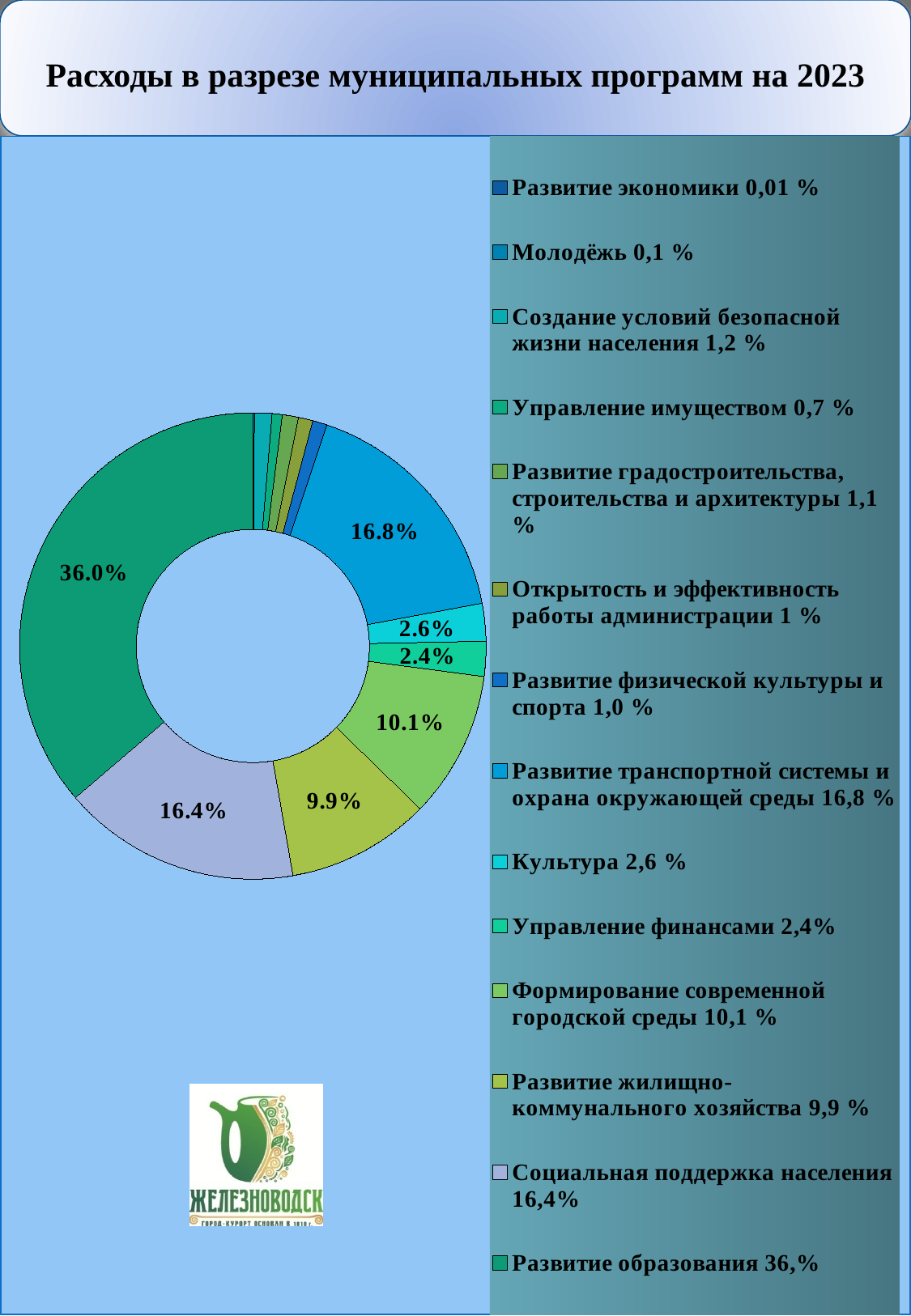
What is the title of the slide? Расходы в разрезе муниципальных программ на 2023 What kind of chart is shown on the slide? pie chart (doughnut) What is the difference between the shares of Развитие образования and Социальная поддержка населения? 19.6% What share is shown for Формирование современной городской среды? 10.1% Which is larger: the share for Культура or the share for Управление финансами? Культура What share is shown for Социальная поддержка населения? 16.4% Which program has the smallest share of expenditure? Развитие экономики Which program has the largest share of expenditure? Развитие образования According to the legend, what share is shown for Молодёжь? 0,1 % What share of expenditure goes to Развитие образования? 36.0% How many programs (categories) are listed in the legend? 14 What share is shown for Развитие транспортной системы и охрана окружающей среды? 16.8%